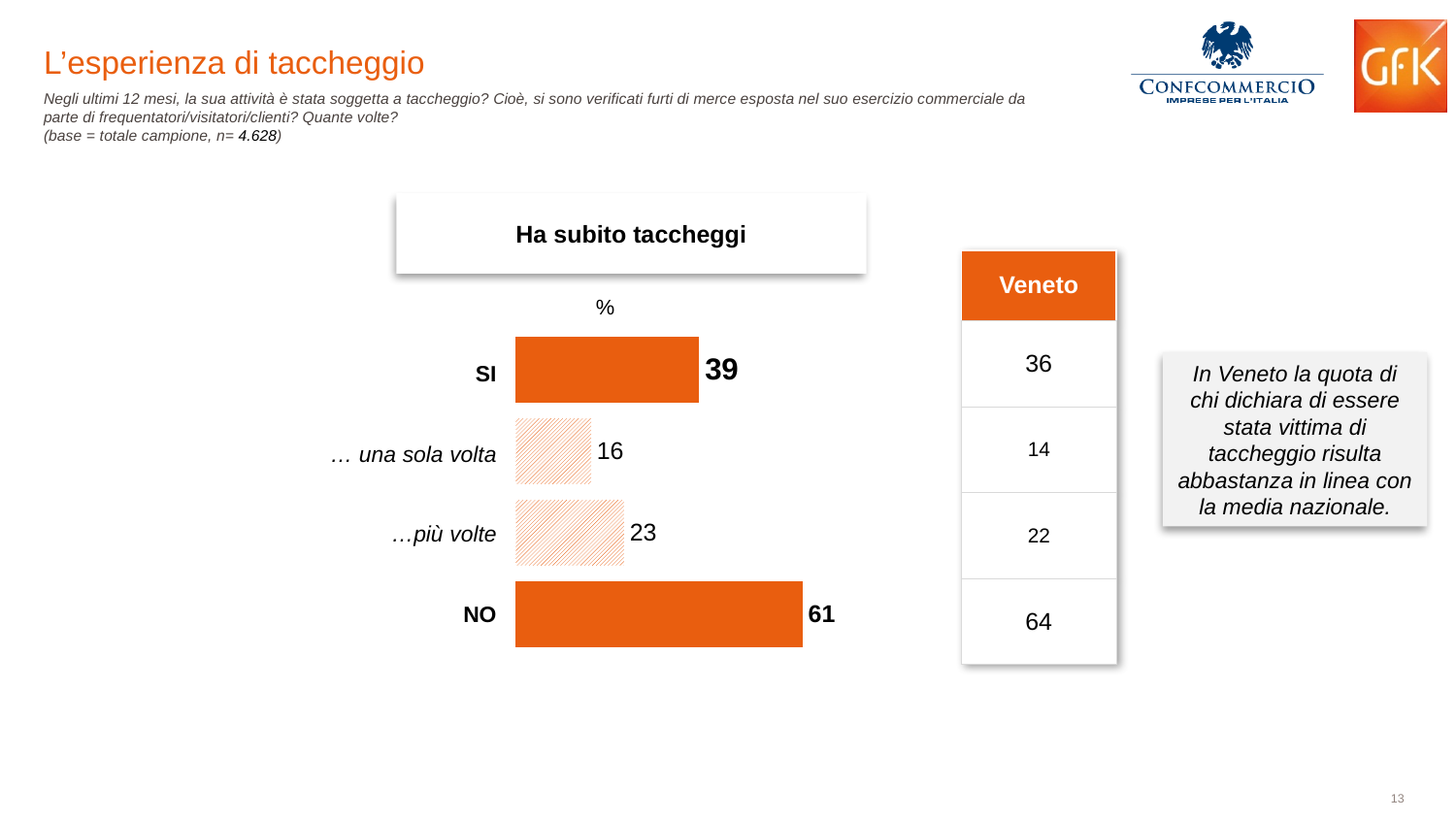
What is the value for '… una sola volta' in the 'Ha subito taccheggi' chart? 16 In the 'Ha subito taccheggi' chart, which is larger: the value for '…più volte' or the value for '… una sola volta'? …più volte Which category has the highest value in the 'Ha subito taccheggi' chart? NO What unit label is shown above the bars in the 'Ha subito taccheggi' chart? % What is the value for NO in the 'Ha subito taccheggi' chart? 61 What is the difference between the values for NO and SI in the 'Ha subito taccheggi' chart? 22 What type of chart is 'Ha subito taccheggi'? Bar chart What is the value for '…più volte' in the 'Ha subito taccheggi' chart? 23 What is the difference between the values for '…più volte' and '… una sola volta' in the 'Ha subito taccheggi' chart? 7 What is the value for SI in the 'Ha subito taccheggi' chart? 39 Which category has the lowest value in the 'Ha subito taccheggi' chart? … una sola volta How many bars are shown in the 'Ha subito taccheggi' chart? 4